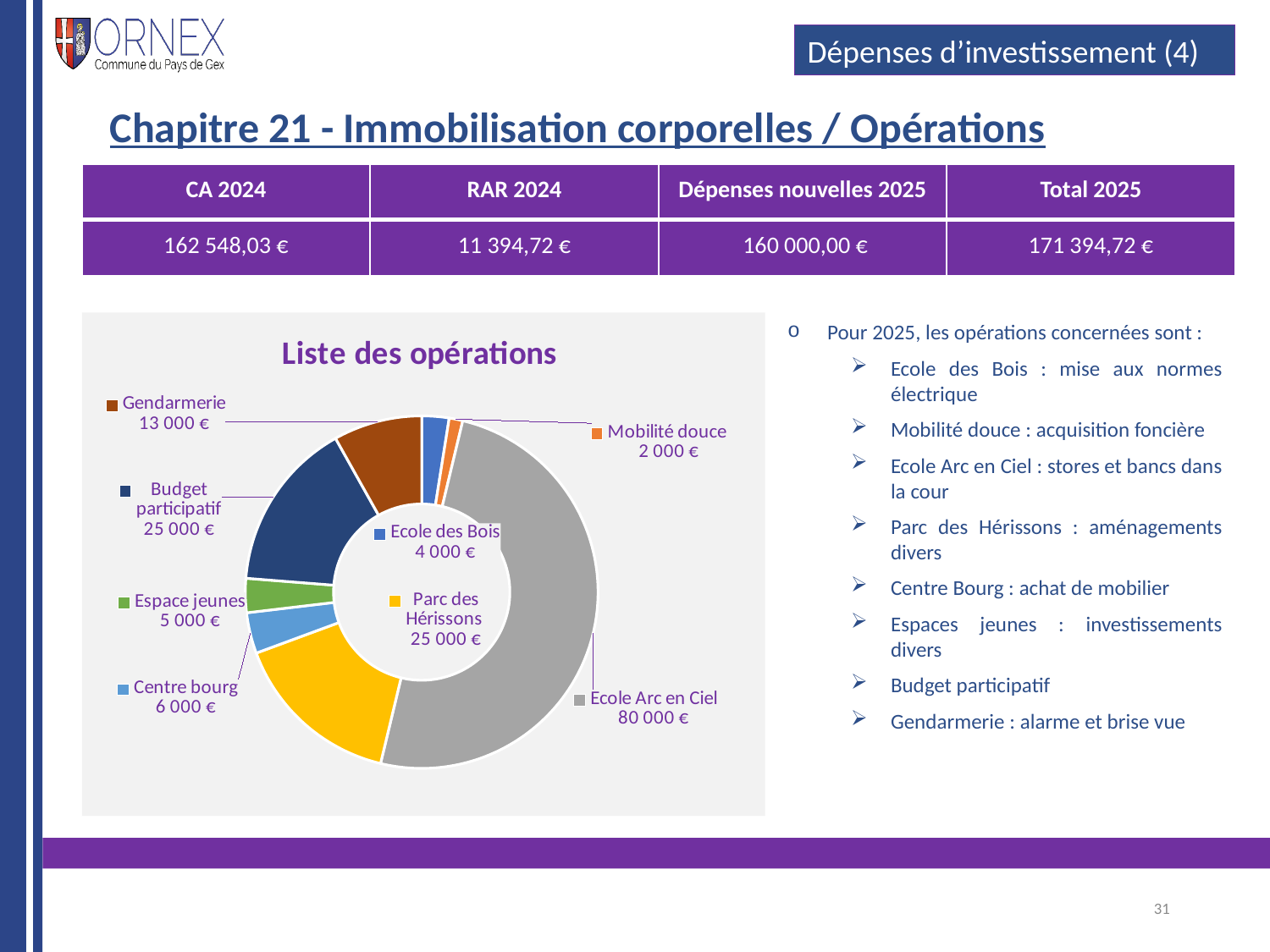
What is the value for Centre bourg in the 'Liste des opérations' chart? 6 000 € Which operation has the largest value in the 'Liste des opérations' chart? Ecole Arc en Ciel What is the value for Ecole Arc en Ciel in the 'Liste des opérations' chart? 80 000 € Which operation has the smallest value in the 'Liste des opérations' chart? Mobilité douce In the 'Liste des opérations' chart, which is larger: Centre bourg or Espace jeunes? Centre bourg What is the value for Mobilité douce in the 'Liste des opérations' chart? 2 000 € What is the title of the chart on the slide? Liste des opérations In the 'Liste des opérations' chart, what is the difference between Ecole Arc en Ciel and Parc des Hérissons? 55 000 € How many operations are shown in the 'Liste des opérations' chart? 8 What is the value for Gendarmerie in the 'Liste des opérations' chart? 13 000 € What share of the total in the 'Liste des opérations' chart does Ecole Arc en Ciel represent? 50% What kind of chart is 'Liste des opérations'? Doughnut chart